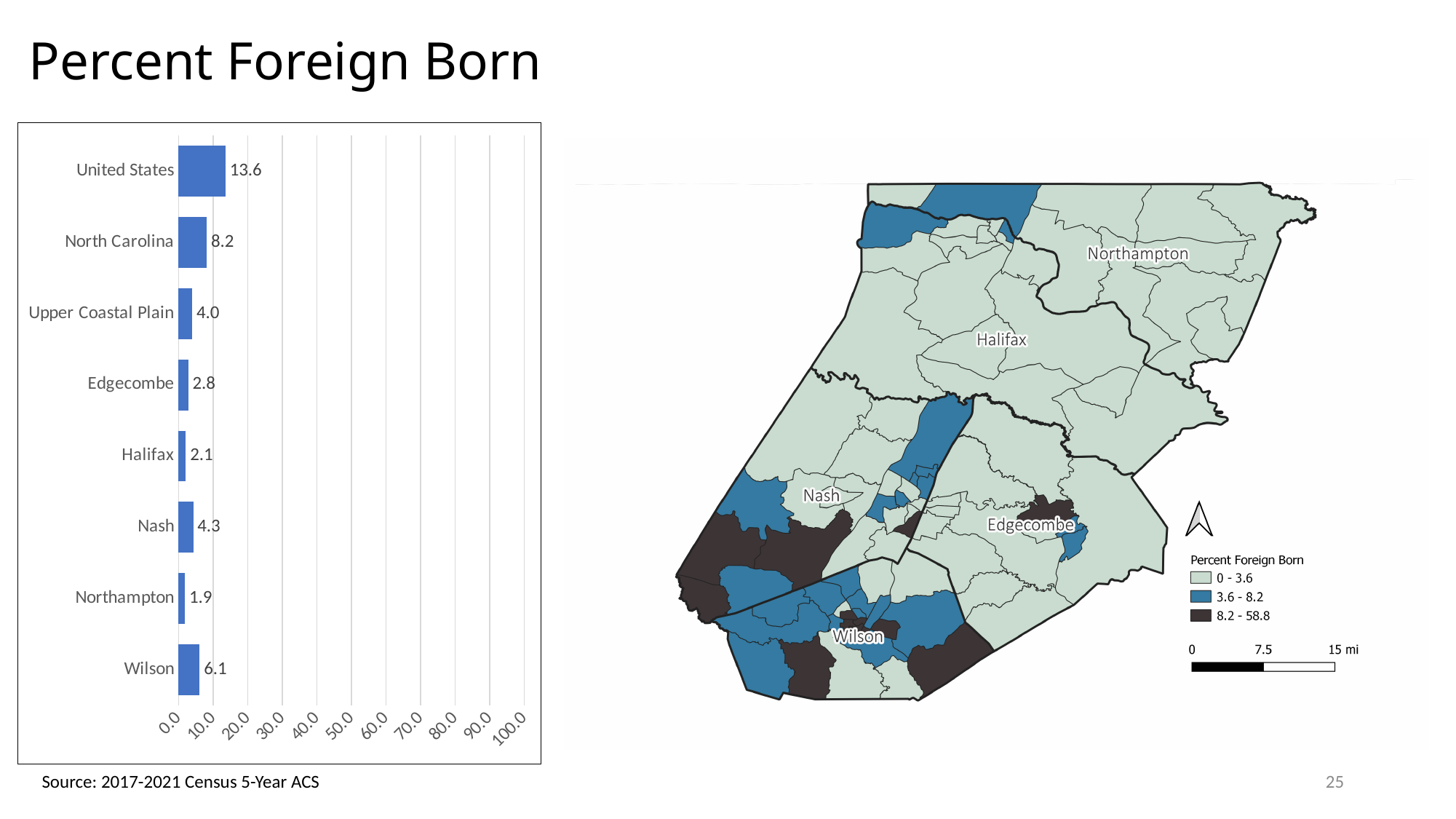
In the bar chart, what is the value for Wilson? 6.1 In the bar chart, which category has the lowest percent foreign born? Northampton In the bar chart, what is the percent foreign born for the United States? 13.6 In the bar chart, what is the value for Upper Coastal Plain? 4.0 How many categories are shown in the bar chart? 8 In the bar chart, what is the difference between the United States value and the North Carolina value? 5.4 In the bar chart, is the value for Halifax greater or less than 10.0? less What is the highest value shown on the x axis of the bar chart? 100.0 In the bar chart, which category has the highest percent foreign born? United States In the bar chart, what is the percent foreign born for North Carolina? 8.2 What kind of chart is on the left side of the slide? bar chart In the bar chart, which is larger, the value for Nash or the value for Edgecombe? Nash